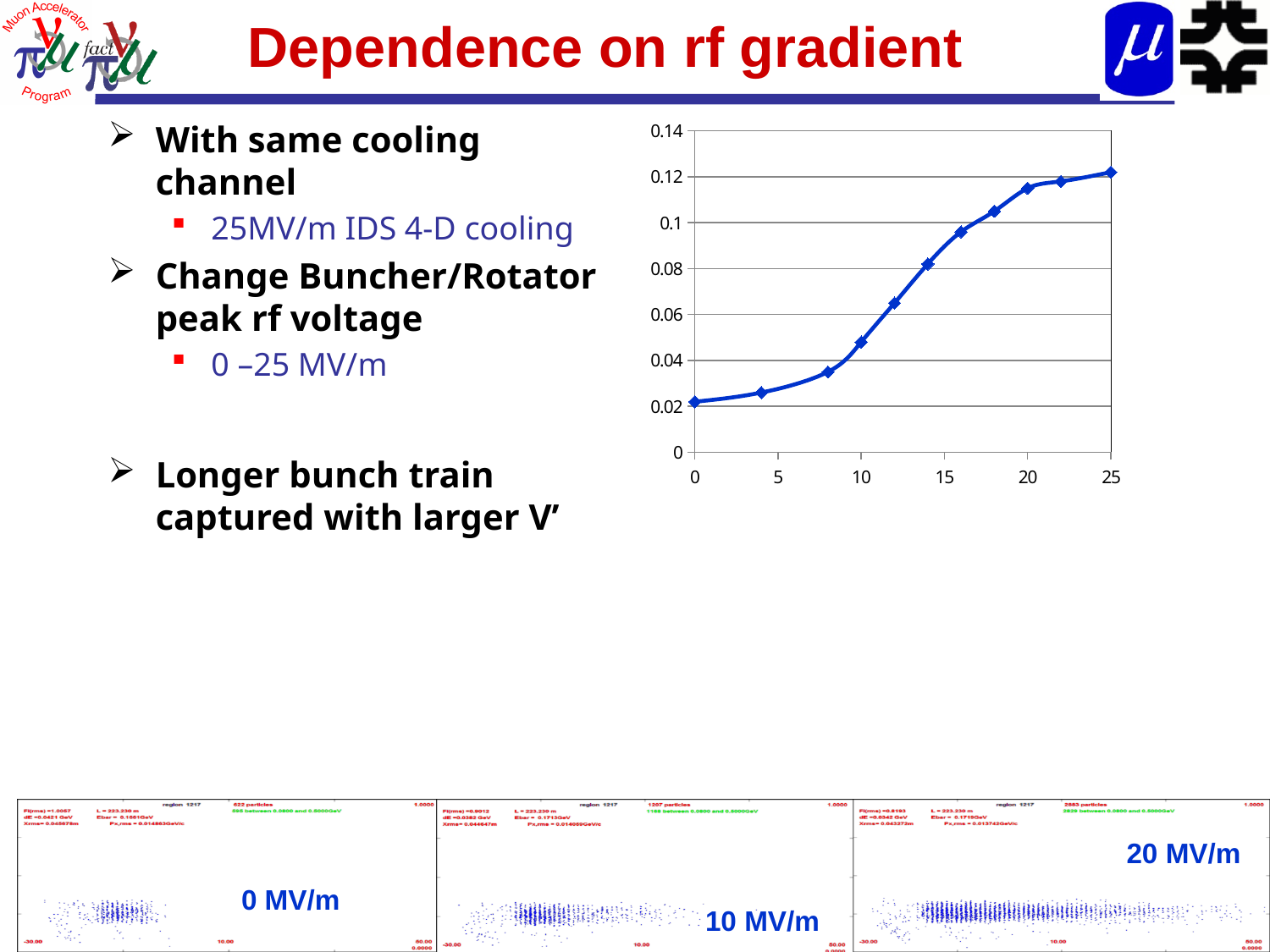
On the line chart, which has the larger value: x = 10 or x = 20? x = 20 Is the value at x = 14 on the line chart greater or less than 0.06? greater What kind of chart is shown on the slide? line chart Is the value at x = 25 on the line chart greater or less than 0.1? greater How many data points are plotted on the line chart? 11 Do the values on the line chart rise or fall as the x axis increases from 0 to 25? rise Is the value at x = 0 on the line chart greater or less than 0.04? less At which x value does the line chart have its lowest point? 0 What is the highest tick value shown on the y axis of the line chart? 0.14 What is the highest tick value shown on the x axis of the line chart? 25 At which x value does the line chart reach its highest point? 25